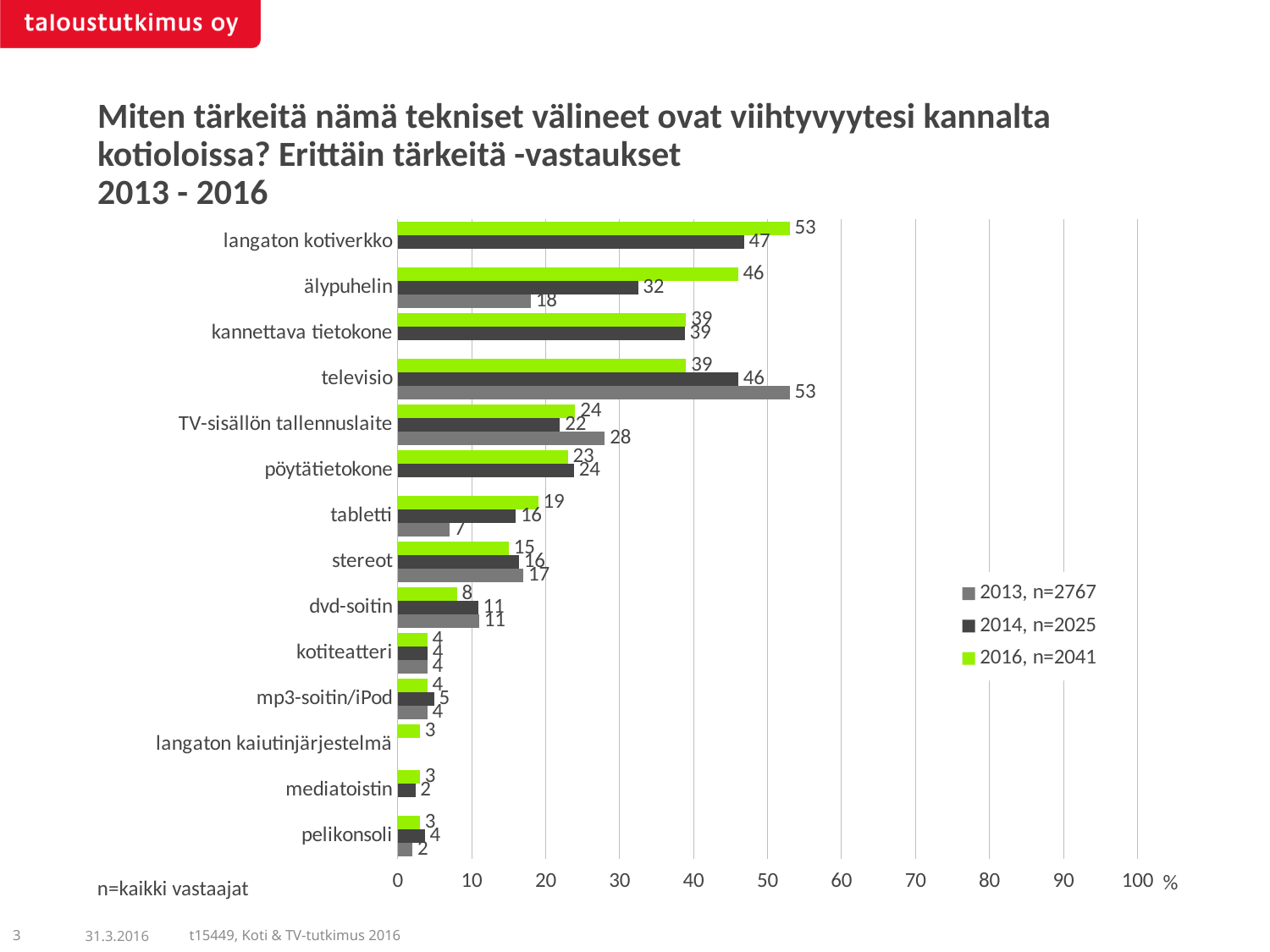
What is the 2013 value for tabletti? 7 What kind of chart is shown on the slide? bar chart What is the difference between the 2013 and 2016 values for televisio? 14 Which category has the highest 2016 value? langaton kotiverkko Which category has the highest 2013 value? televisio Which is larger for tabletti, the 2016 value or the 2013 value? 2016 How many series does the legend list? 3 What is the 2016 value for langaton kotiverkko? 53 What is the difference between the 2016 and 2013 values for älypuhelin? 28 How many categories are shown on the chart? 14 What is the 2013 value for televisio? 53 What is the 2014 value for älypuhelin? 32